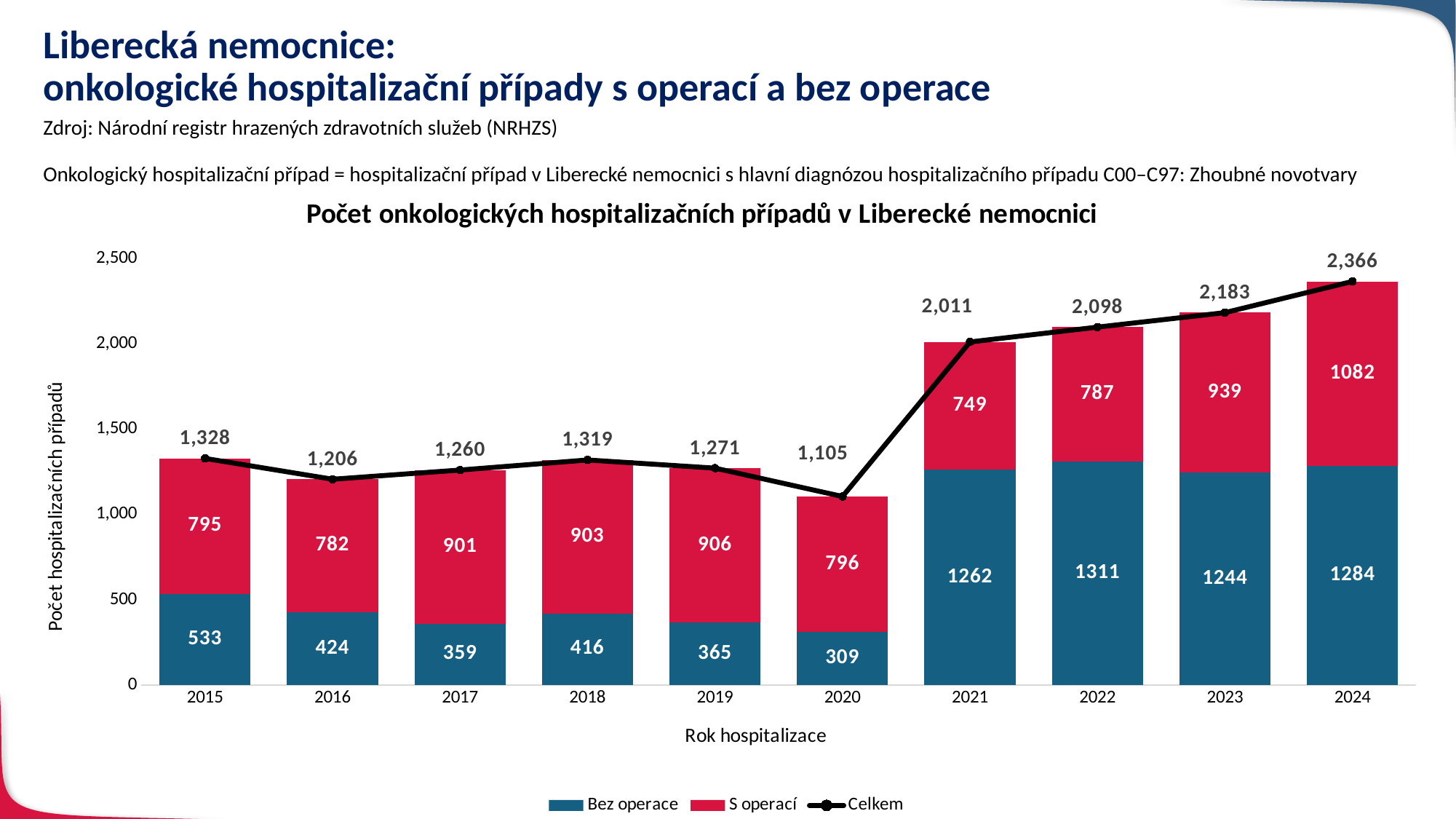
Does the 'Celkem' value rise or fall from 2020 to 2024? Rise What kind of chart is shown? Stacked bar chart with a line Which year has the highest 'Celkem' value? 2024 How many years are shown on the x axis? 10 What is the value of 'Bez operace' for 2015? 533 How many series does the legend list? 3 What is the 'Celkem' value for 2020? 1,105 What is the difference between the 'S operací' values for 2024 and 2023? 143 Which is larger: the 'Bez operace' value for 2022 or for 2021? 2022 What is the title of the chart? Počet onkologických hospitalizačních případů v Liberecké nemocnici Which year has the lowest 'Bez operace' value? 2020 What is the value of 'S operací' for 2024? 1082